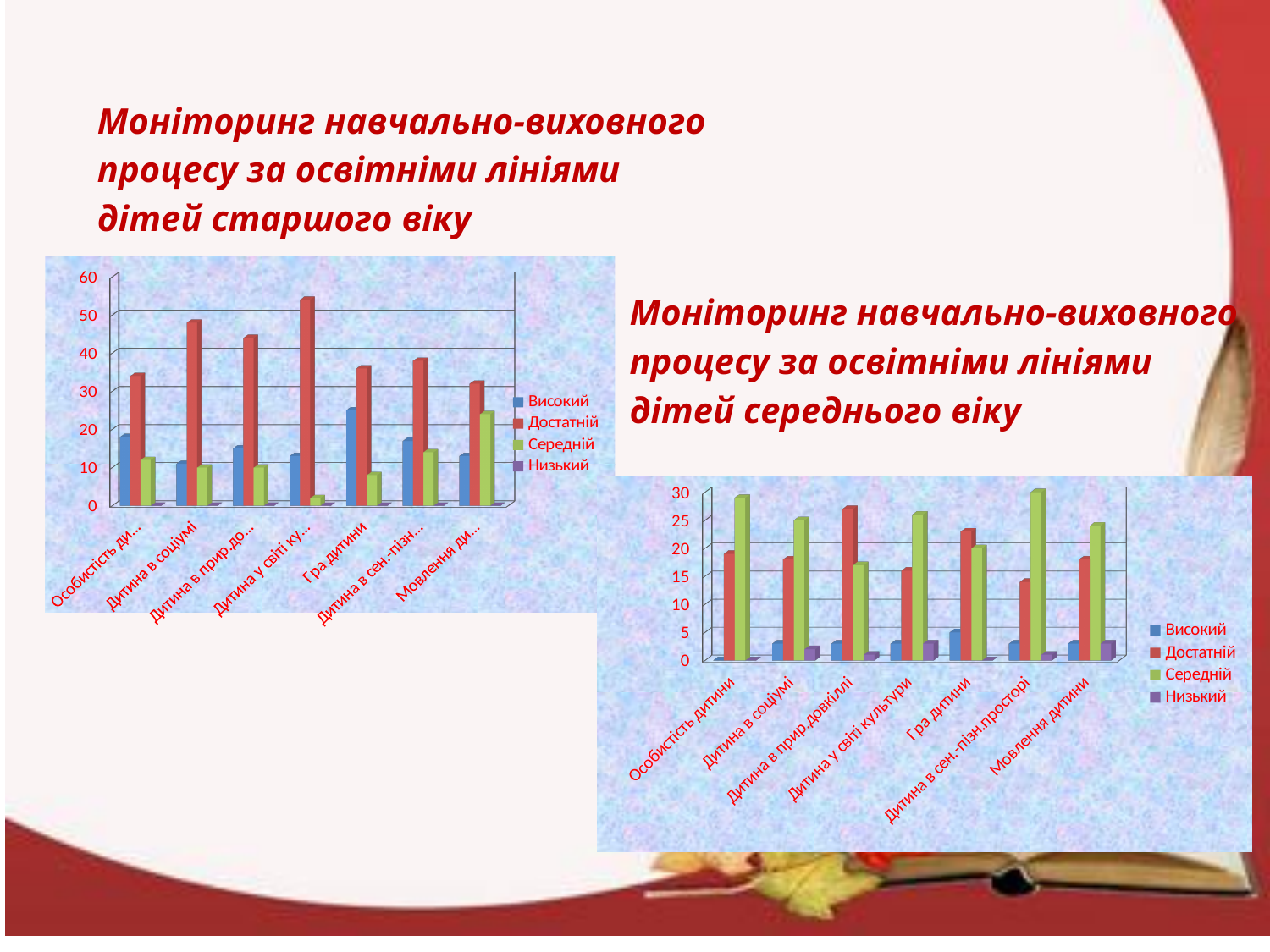
In the left chart (дітей старшого віку), which is larger for Гра дитини: the Високий bar or the Достатній bar? Достатній In the left chart (дітей старшого віку), is the Високий value for Гра дитини greater or less than 20? greater In the right chart (дітей середнього віку), which is larger for Особистість дитини: the Достатній bar or the Середній bar? Середній In the right chart (дітей середнього віку), which category has the highest Середній bar? Дитина в сен.-пізн.просторі In the left chart (дітей старшого віку), which category has the highest Достатній bar? Дитина у світі ку... How many categories are shown on the x axis of the right chart (дітей середнього віку)? 7 In the right chart (дітей середнього віку), which category has the highest Достатній bar? Дитина в прир.довкіллі In the left chart (дітей старшого віку), is the Достатній value for Дитина в соціумі greater or less than 40? greater How many series does the legend of the right chart (дітей середнього віку) list? 4 In the left chart (дітей старшого віку), is the Середній value for Дитина у світі ку... greater or less than 10? less What kind of chart is the left chart (дітей старшого віку)? bar chart